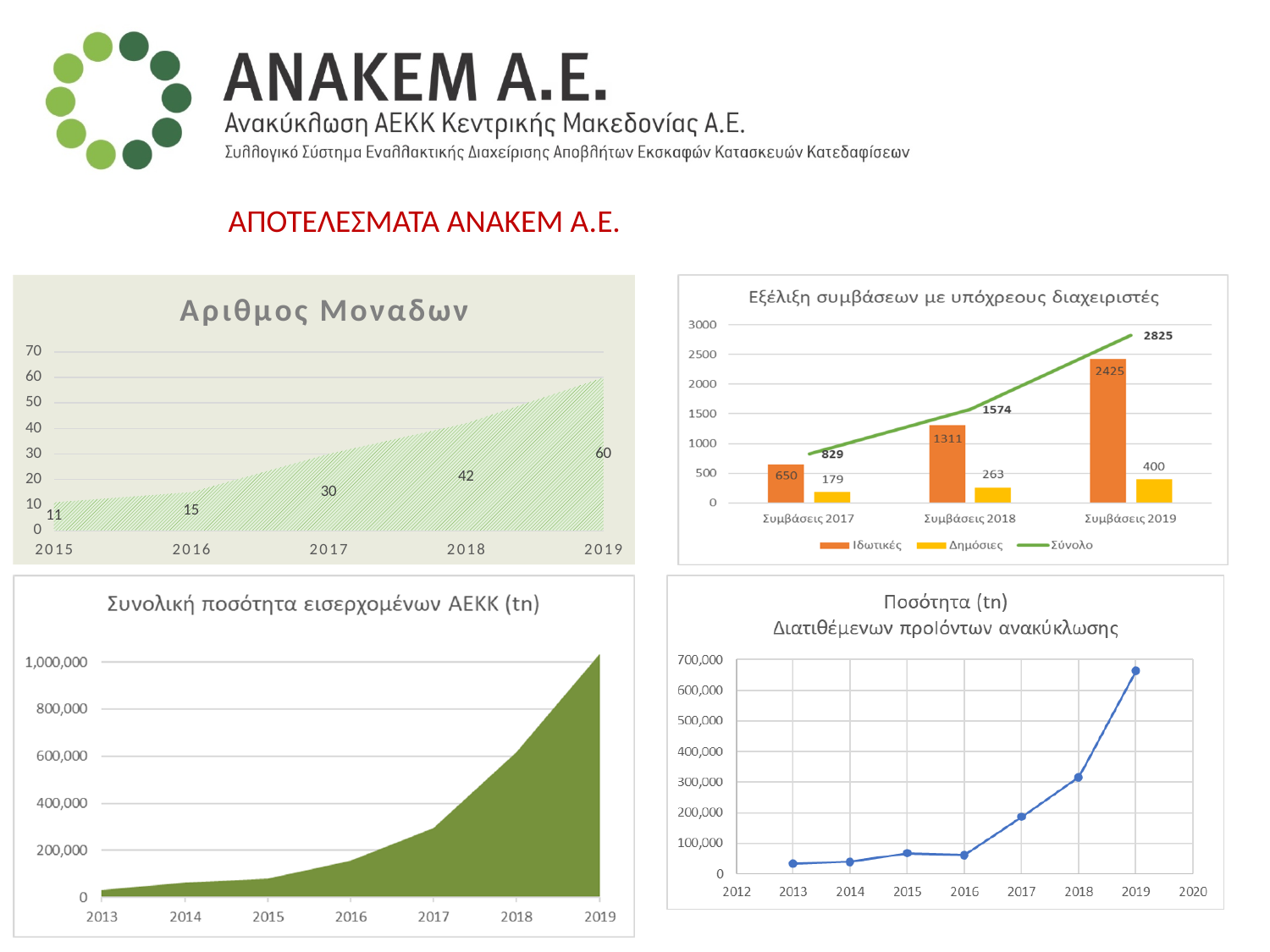
In the chart titled "Εξέλιξη συμβάσεων με υπόχρεους διαχειριστές", what is the difference between Ιδιωτικές and Δημόσιες for Συμβάσεις 2017? 471 In the chart titled "Εξέλιξη συμβάσεων με υπόχρεους διαχειριστές", how many series does the legend list? 3 In the chart titled "Εξέλιξη συμβάσεων με υπόχρεους διαχειριστές", what is the value of Ιδιωτικές for Συμβάσεις 2018? 1311 In the chart titled "Αριθμος Μοναδων", how many years are plotted? 5 In the chart titled "Συνολική ποσότητα εισερχομένων ΑΕΚΚ (tn)", do the values rise or fall from 2013 to 2019? rise In the chart titled "Αριθμος Μοναδων", what is the difference between the values for 2019 and 2018? 18 In the chart titled "Ποσότητα (tn) Διατιθέμενων προϊόντων ανακύκλωσης", is the value for 2018 greater or less than 200,000? greater In the chart titled "Αριθμος Μοναδων", which year has the highest value? 2019 In the chart titled "Συνολική ποσότητα εισερχομένων ΑΕΚΚ (tn)", is the value for 2019 greater or less than 800,000? greater In the chart titled "Αριθμος Μοναδων", what is the value for 2017? 30 In the chart titled "Εξέλιξη συμβάσεων με υπόχρεους διαχειριστές", what is the Σύνολο value for Συμβάσεις 2019? 2825 In the chart titled "Εξέλιξη συμβάσεων με υπόχρεους διαχειριστές", which is larger for Συμβάσεις 2019: Ιδιωτικές or Δημόσιες? Ιδιωτικές